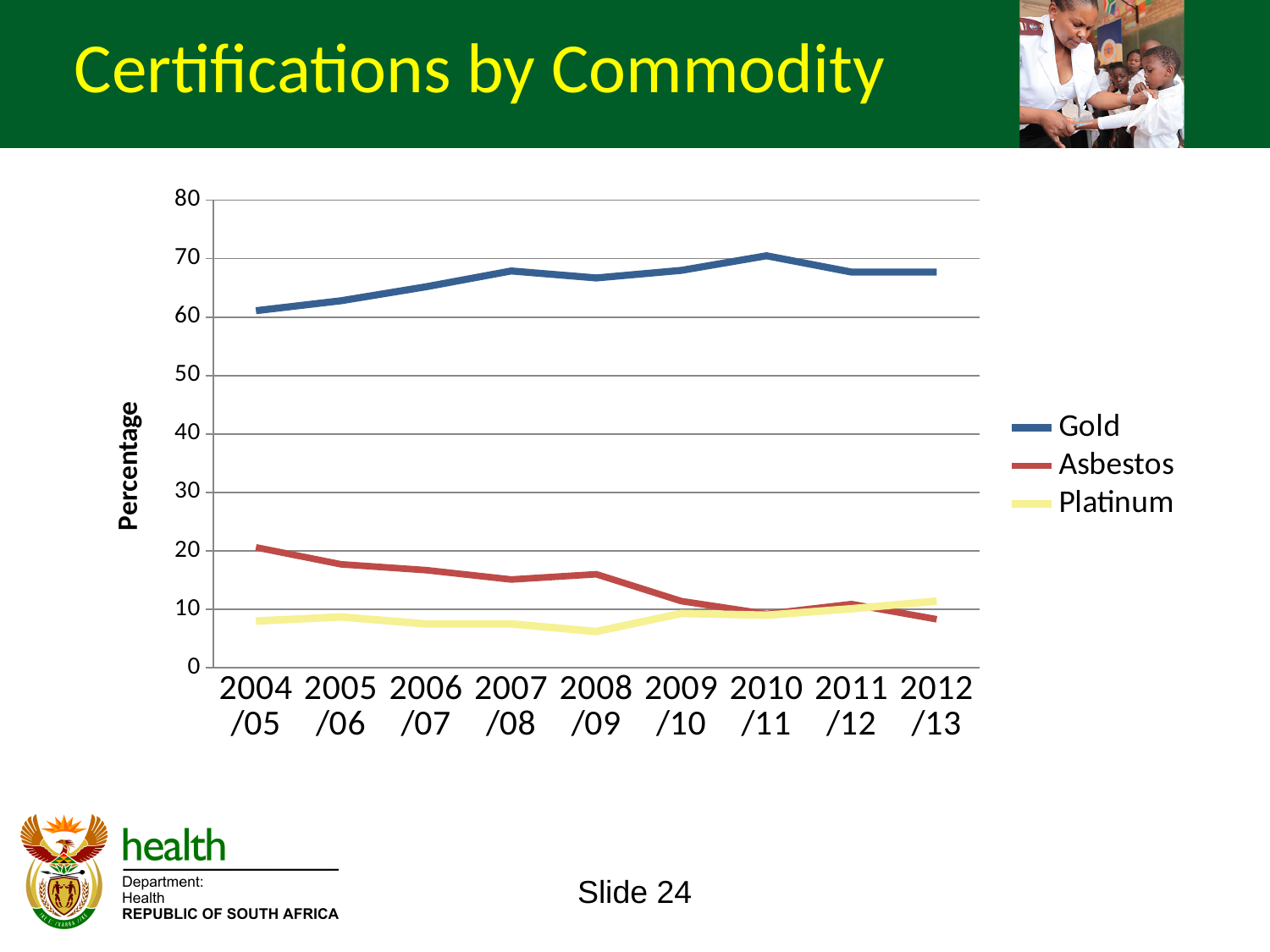
How many series does the legend list? 3 In which year is the Asbestos value highest? 2004/05 Is the Asbestos value for 2004/05 greater or less than 30? less What kind of chart is shown on the slide? Line chart Is the Platinum value for 2008/09 greater or less than 10? less In 2012/13, which is larger, the Platinum value or the Asbestos value? Platinum How many years are plotted along the x axis? 9 Does the Asbestos line generally rise or fall from 2004/05 to 2012/13? Fall Which series has the highest values across all years? Gold In which year does the Gold line reach its highest point? 2010/11 Is the Gold value for 2007/08 greater or less than 60? greater In which year is the Platinum value lowest? 2008/09